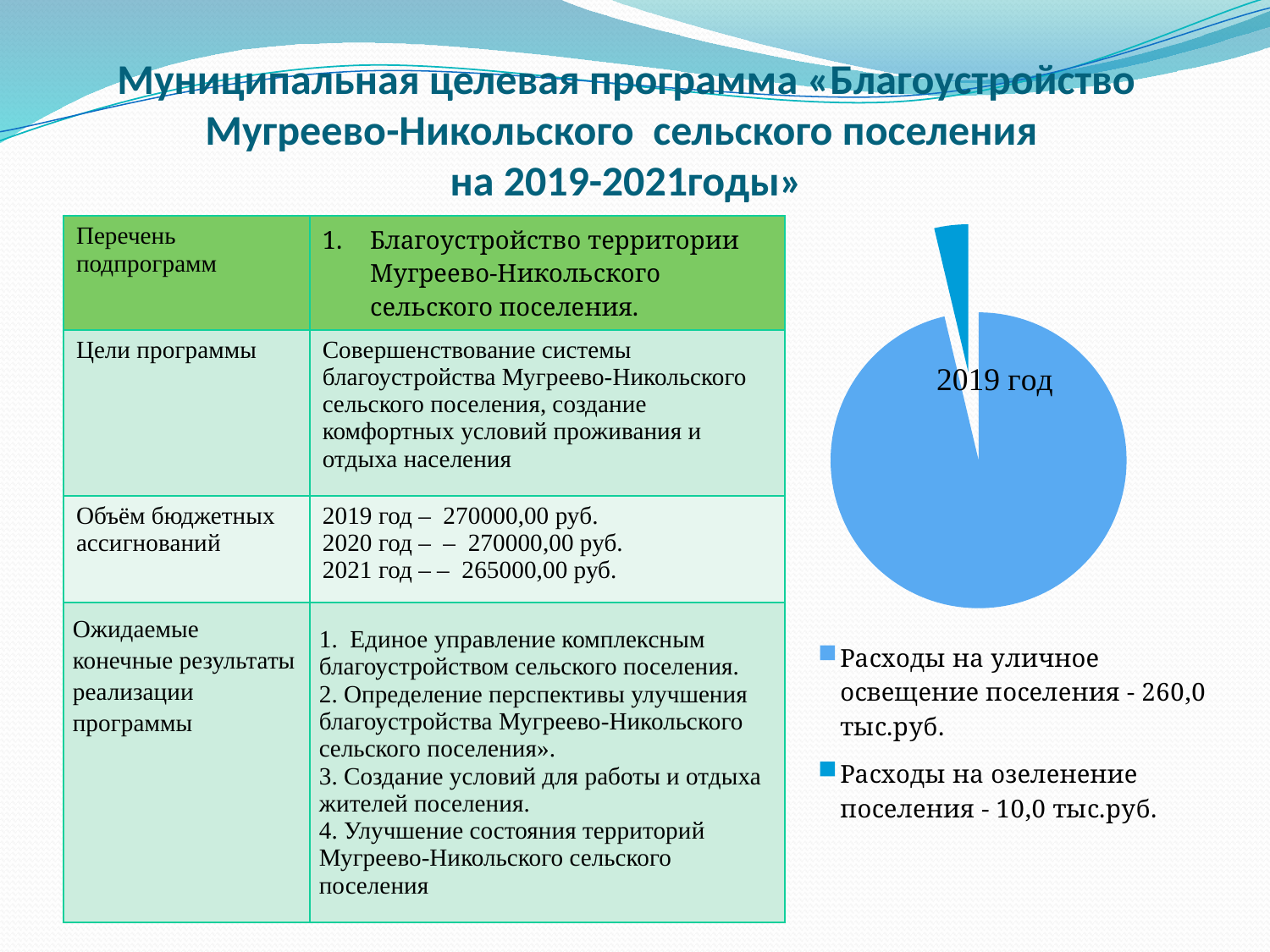
What kind of chart is shown on the right side of the slide? pie chart What is the difference between the street lighting expenses and the greening expenses shown beside the pie chart? 250,0 тыс.руб. What label is printed inside the pie chart? 2019 год Which slice of the pie chart is larger: street lighting expenses (уличное освещение) or greening expenses (озеленение)? уличное освещение How many slices does the pie chart have? 2 What is the total of the two expense items shown beside the pie chart? 270,0 тыс.руб. Is the small slice of the pie chart pulled out (exploded) from the rest of the pie? yes According to the text beside the pie chart, what are the expenses on greening (озеленение) for 2019? 10,0 тыс.руб. According to the text beside the pie chart, what are the expenses on street lighting (уличное освещение) for 2019? 260,0 тыс.руб. Which expense category takes the largest share of the pie chart? Расходы на уличное освещение поселения Which expense category takes the smallest share of the pie chart? Расходы на озеленение поселения